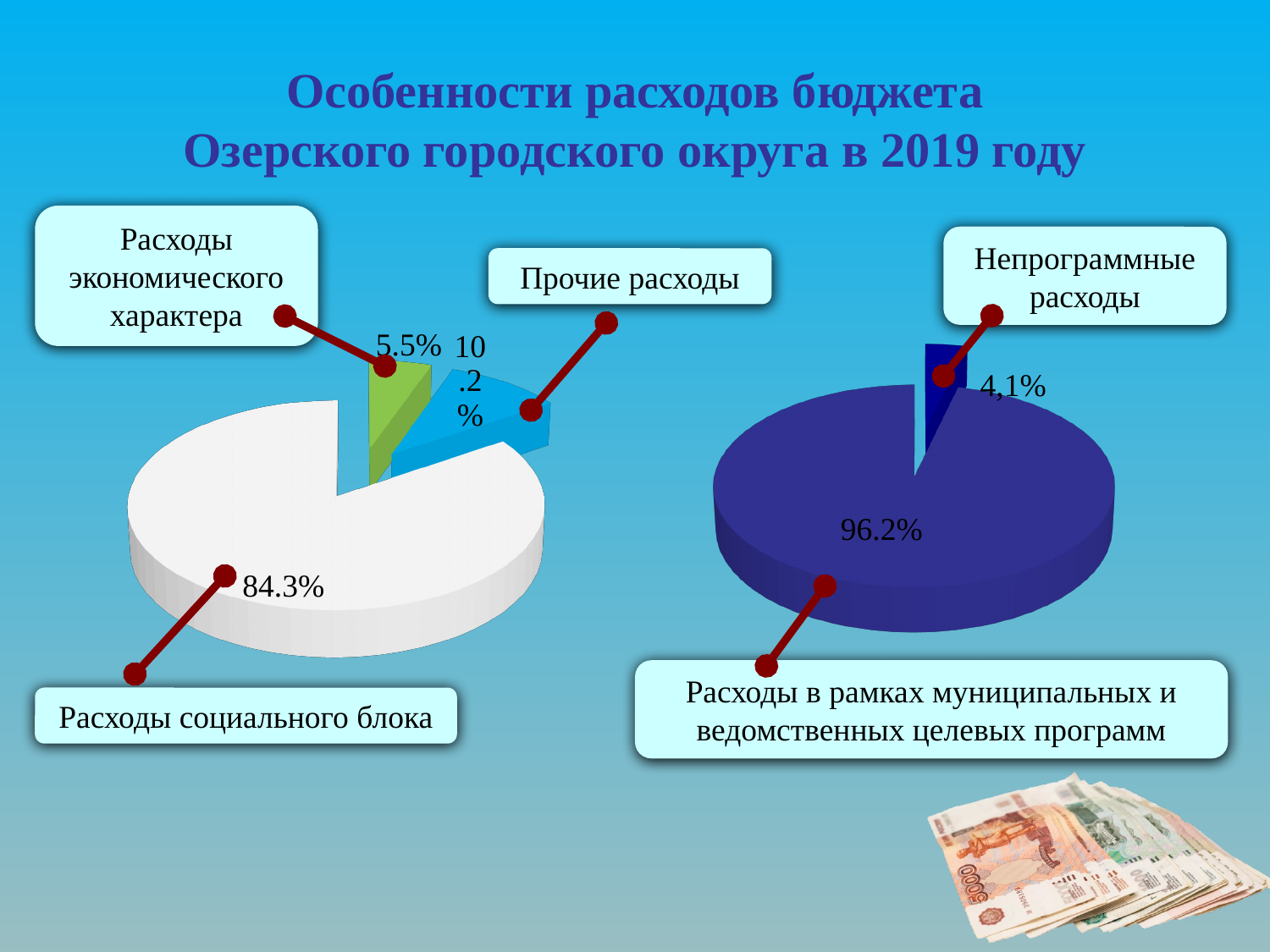
On the right pie chart, what share is shown for Расходы в рамках муниципальных и ведомственных целевых программ? 96.2% What type of chart is the right chart on the slide? Pie chart On the left pie chart, which category has the smallest share? Расходы экономического характера On the right pie chart, what share is shown for Непрограммные расходы? 4,1% On the left pie chart, what is the difference between the shares of Прочие расходы and Расходы экономического характера? 4.7% On the left pie chart, what share is shown for Прочие расходы? 10.2% On the left pie chart, which is larger: Прочие расходы or Расходы экономического характера? Прочие расходы How many slices does the left pie chart have? 3 On the left pie chart, which category has the largest share? Расходы социального блока On the left pie chart, what share is shown for Расходы социального блока? 84.3% On the left pie chart, what share is shown for Расходы экономического характера? 5.5% On the right pie chart, which category has the smallest share? Непрограммные расходы